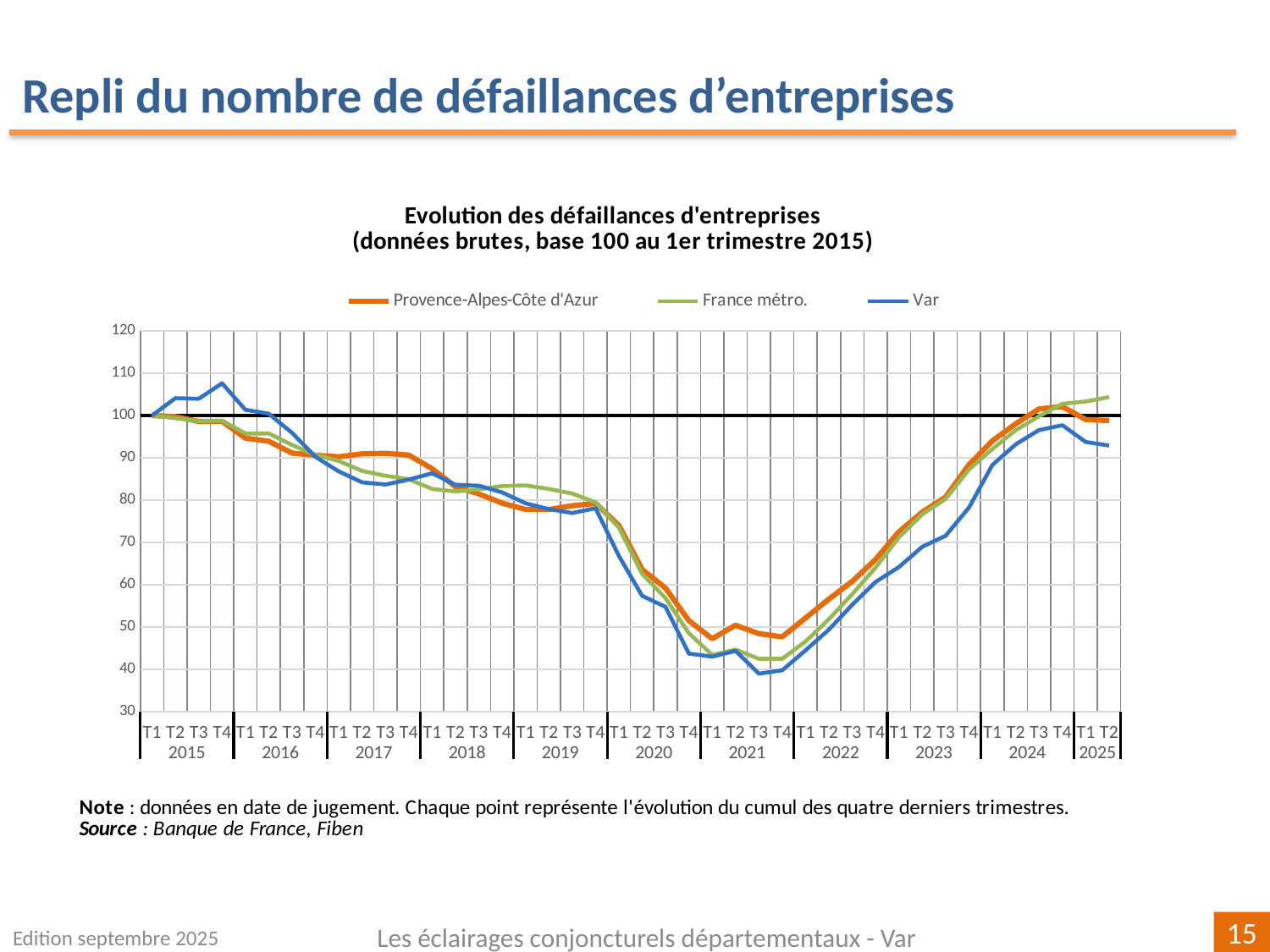
Which series has the highest value at T4 2015? Var Is the value for France métro. at T2 2025 greater or less than 100? greater Do the values rise or fall between T1 2020 and T3 2021? fall Which series has the lowest value at T3 2021? Var Is the value for Var at T4 2020 greater or less than 50? less At T2 2025, which is higher: France métro. or Var? France métro. What kind of chart is shown on the slide? line chart How many quarters of 2025 are shown on the x axis? 2 What is the value of all three series at T1 2015, the base period? 100 Is the value for Var at T4 2015 greater or less than 100? greater How many series does the legend list? 3